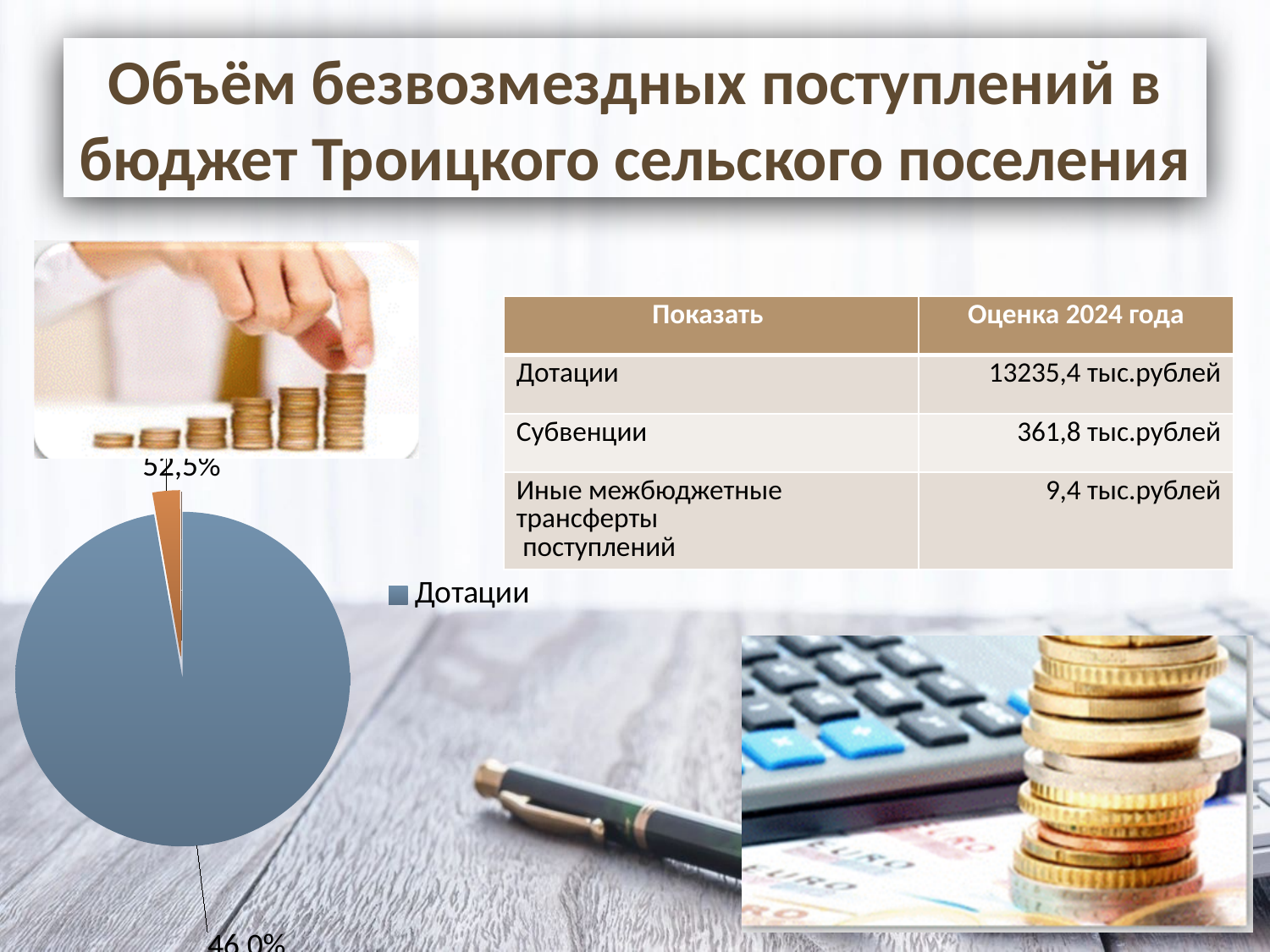
Which colour is used for the Дотации slice in the pie chart? blue What is the entry shown in the legend of the pie chart? Дотации How many entries does the legend of the pie chart list? 1 How many slices does the pie chart have? 2 What kind of chart is shown on the slide? pie chart Which slice of the pie chart is larger, the blue one or the orange one? blue Which slice of the pie chart is the smallest, the blue one or the orange one? orange